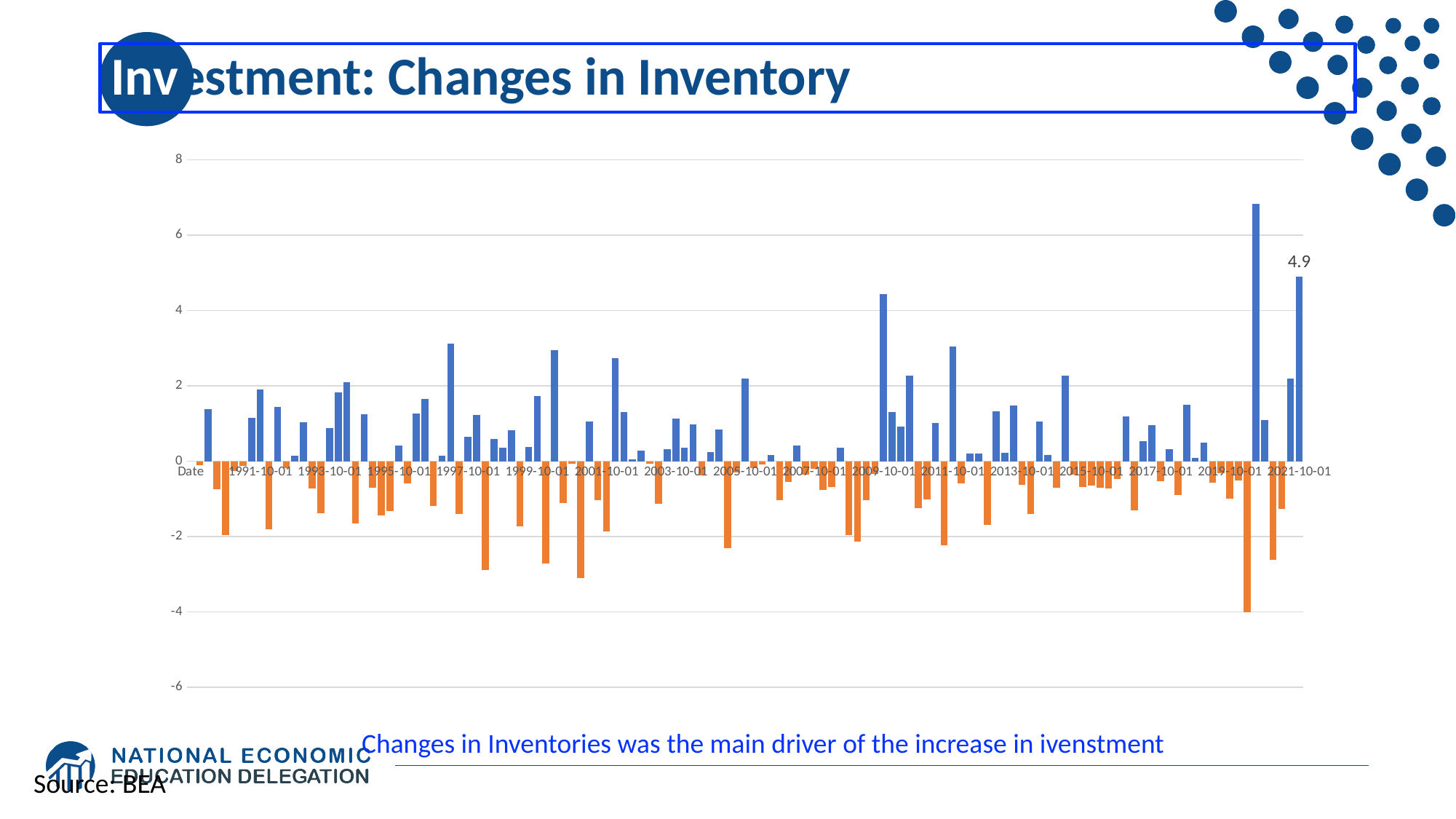
What is the source cited for the chart? BEA What is the highest value shown on the vertical axis? 8 What is the lowest value shown on the vertical axis? -6 How many dated labels are shown along the x axis (excluding the word 'Date')? 16 What kind of chart is shown on the slide? bar chart Is the lowest bar on the chart greater or less than -2? less Is the value for 2021-10-01 greater or less than 4? greater Is the highest bar on the chart greater or less than 6? greater What is the value of the bar labelled with a data label at 2021-10-01? 4.9 Which is larger, the value for 2021-10-01 or the value for 2017-10-01? 2021-10-01